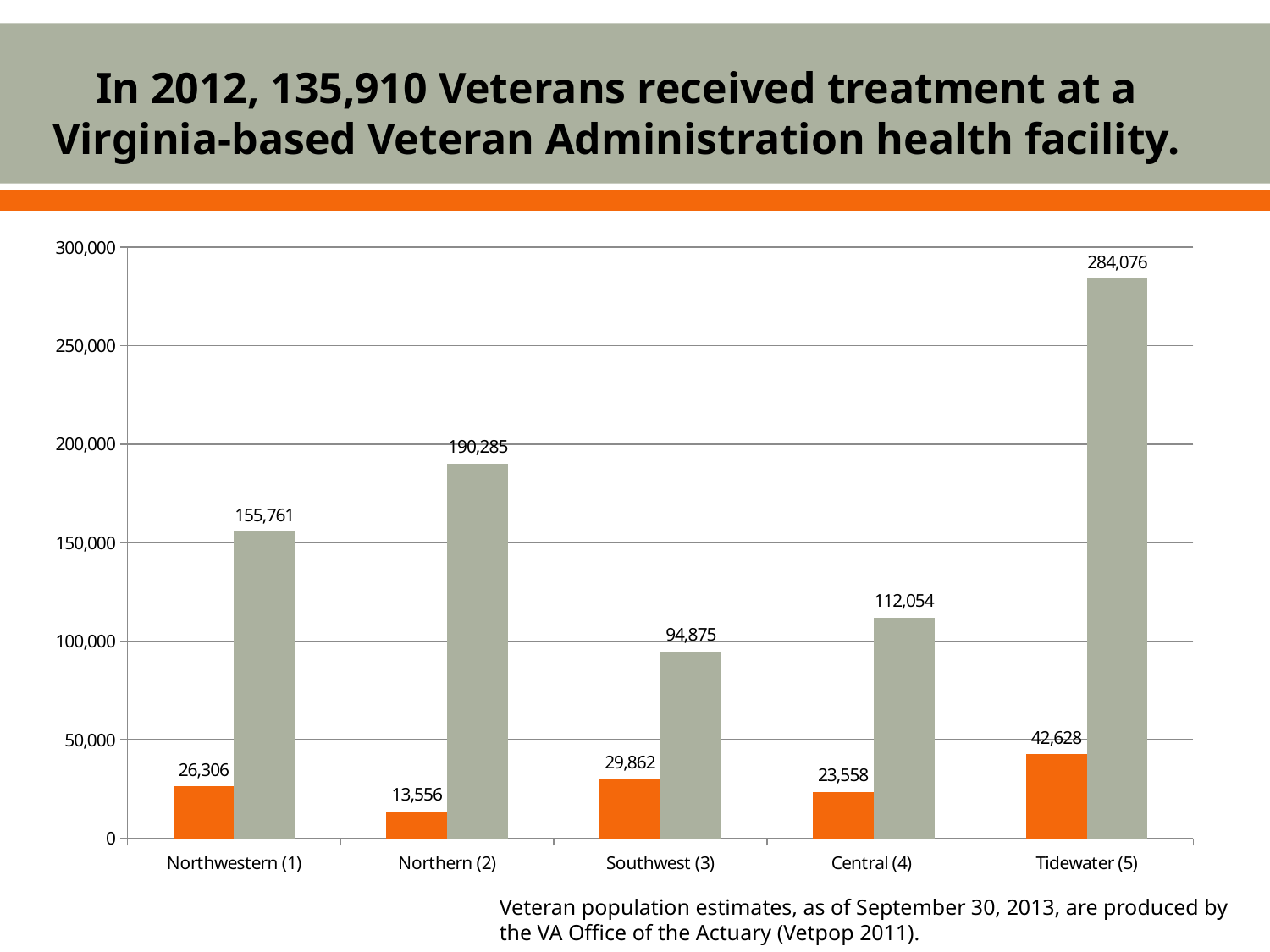
What is the difference between the gray bars for Northern (2) and Northwestern (1)? 34,524 What is the value of the gray bar for Southwest (3)? 94,875 What is the difference between the gray bar and the orange bar for Tidewater (5)? 241,448 What is the highest value shown on the y axis? 300,000 Which region has the highest gray bar? Tidewater (5) What is the value of the orange bar for Northwestern (1)? 26,306 What kind of chart is shown on the slide? Bar chart What is the value of the gray bar for Tidewater (5)? 284,076 How many regions are shown on the x axis? 5 Which region has the lowest orange bar? Northern (2) Which is larger, the gray bar for Central (4) or the gray bar for Southwest (3)? Central (4) What is the value of the orange bar for Central (4)? 23,558